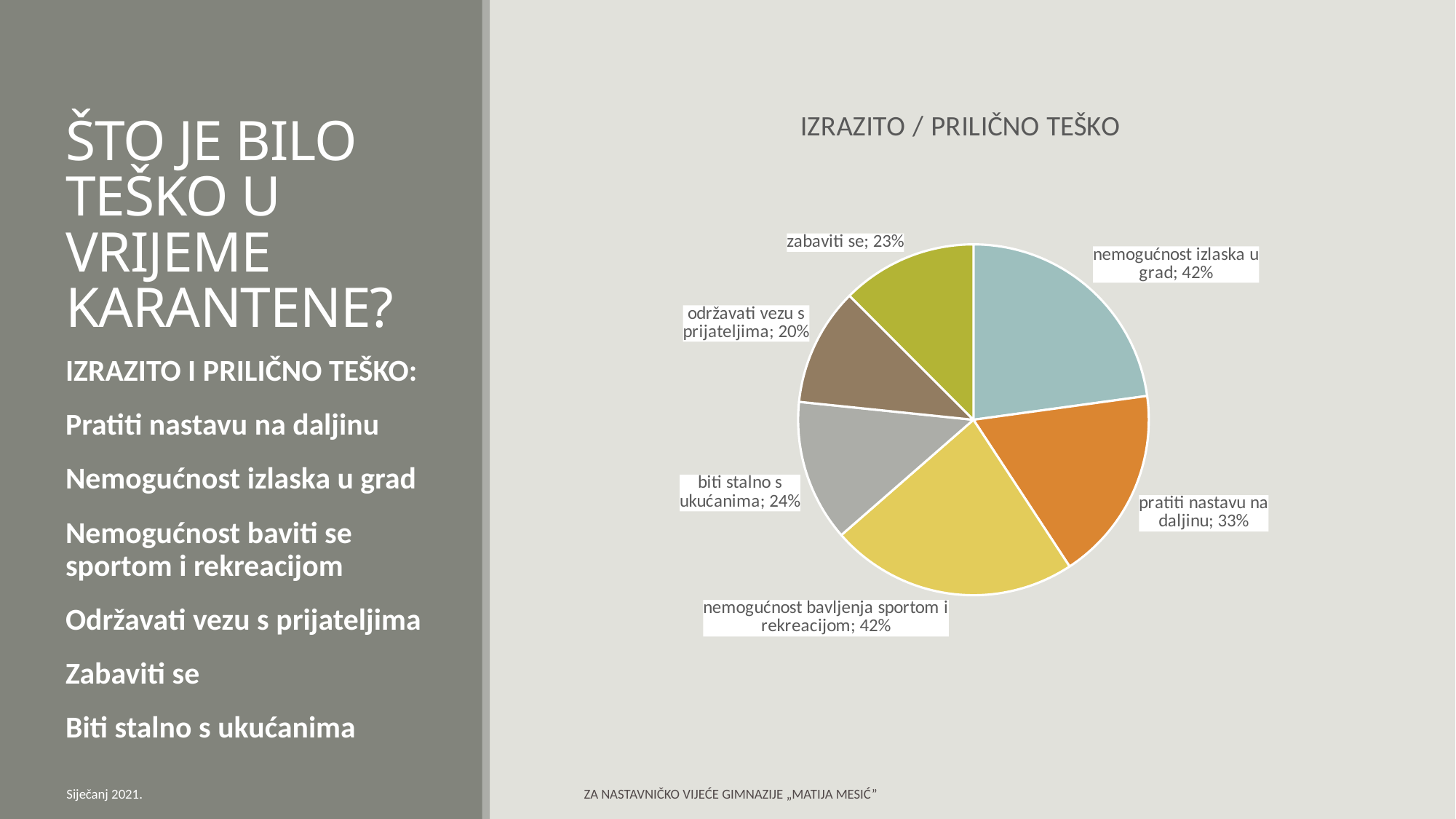
What value is shown for "biti stalno s ukućanima"? 24% What is the difference between the values for "nemogućnost izlaska u grad" and "pratiti nastavu na daljinu"? 9 percentage points What is the title of the chart? IZRAZITO / PRILIČNO TEŠKO Which is larger: the value for "nemogućnost izlaska u grad" or for "pratiti nastavu na daljinu"? nemogućnost izlaska u grad Which category has the lowest value in the pie chart? održavati vezu s prijateljima What value is shown for "zabaviti se"? 23% How many categories (slices) does the pie chart have? 6 What kind of chart is shown on the slide? Pie chart What value is shown for "održavati vezu s prijateljima"? 20% What value is shown for "nemogućnost bavljenja sportom i rekreacijom"? 42% What value is shown for "nemogućnost izlaska u grad"? 42% What value is shown for "pratiti nastavu na daljinu"? 33%